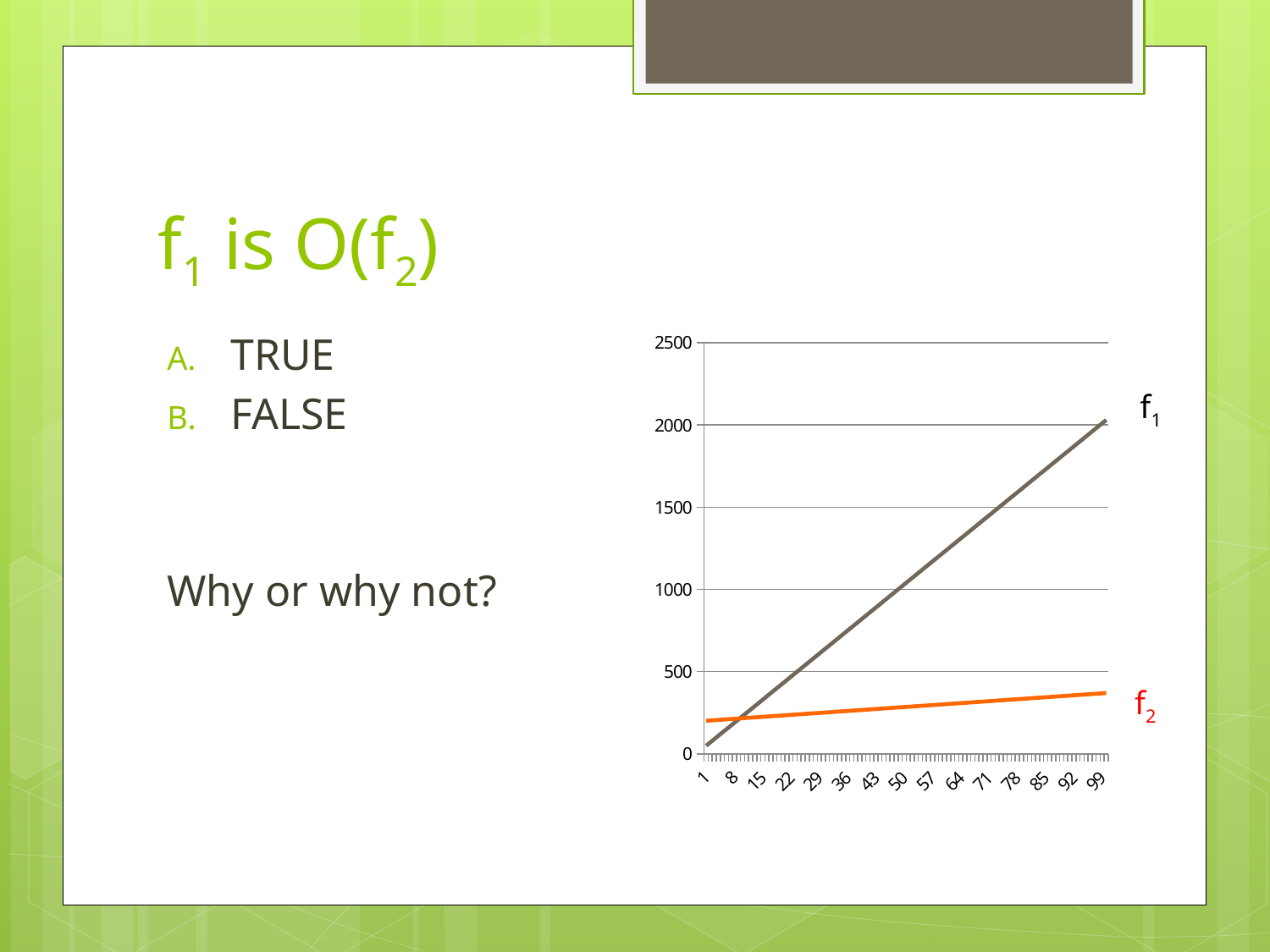
Does the f1 line rise or fall as x increases along the x axis? rise At x = 99, which line is higher, f1 or f2? f1 At x = 1, which line is higher, f1 or f2? f2 What is the highest value shown on the y axis? 2500 Is the value of f1 at x = 1 greater or less than 500? less How many x-axis tick labels are printed on the chart? 15 What kind of chart is shown on the slide? line chart Is the value of f2 at x = 99 greater or less than 500? less Does the f2 line rise or fall as x increases along the x axis? rise How many lines (series) are plotted on the chart? 2 Is the value of f1 at x = 99 greater or less than 1500? greater What are the two series labelled on the chart? f1 and f2